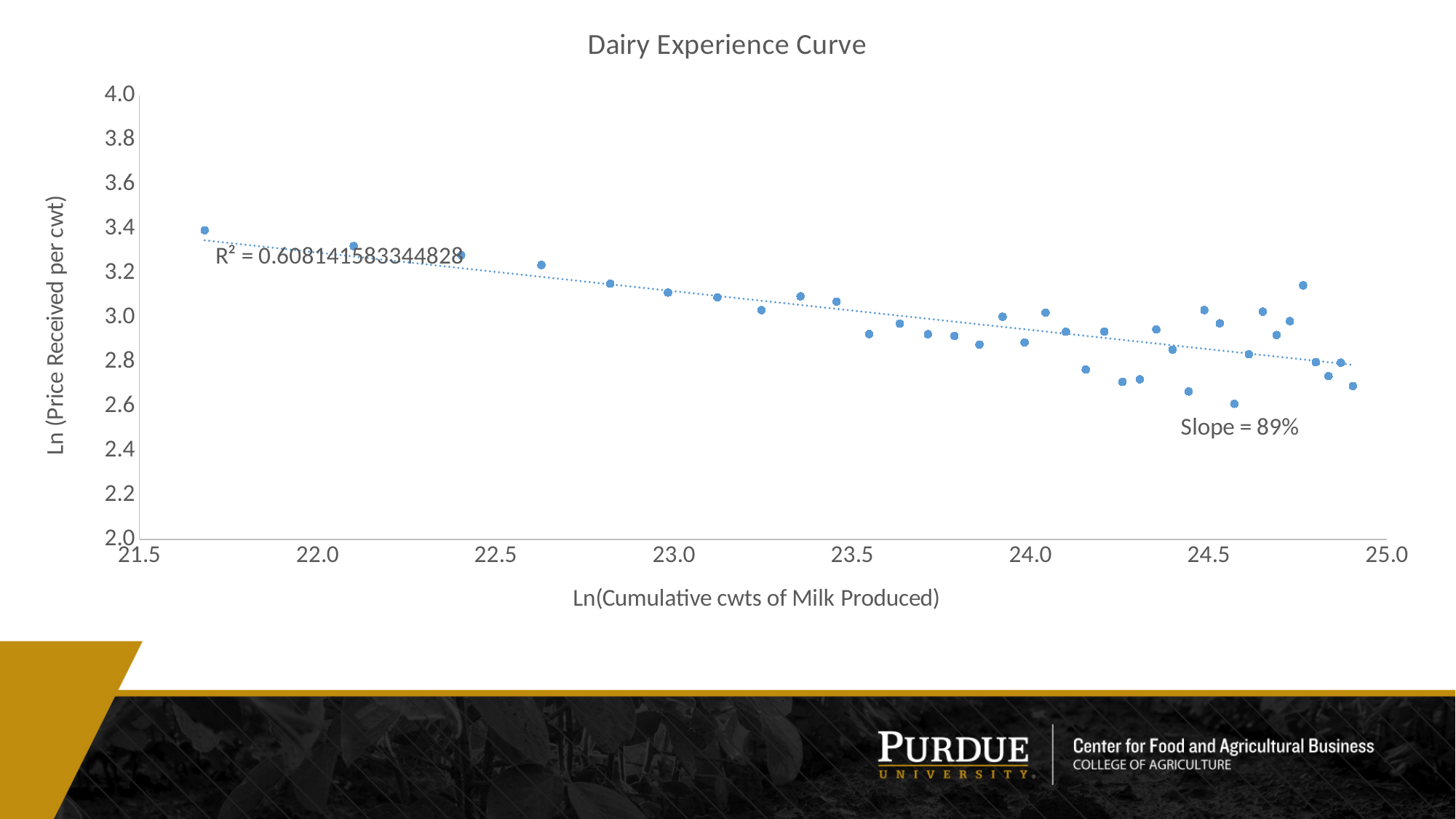
What is the highest value shown on the vertical axis? 4.0 Is the y value of the rightmost point greater or less than 2.8? less Is the y value of the lowest point on the chart greater or less than 2.8? less What R² value is printed on the chart? R² = 0.608141583344828 What slope is annotated on the chart? Slope = 89% What is the title of the chart? Dairy Experience Curve Is the y value of the leftmost point greater or less than 3.2? greater What is the label of the vertical axis? Ln (Price Received per cwt) What kind of chart is shown on the slide? Scatter chart Which has the higher y value: the leftmost point or the rightmost point? The leftmost point Do the plotted values generally rise or fall as Ln(Cumulative cwts of Milk Produced) increases? Fall